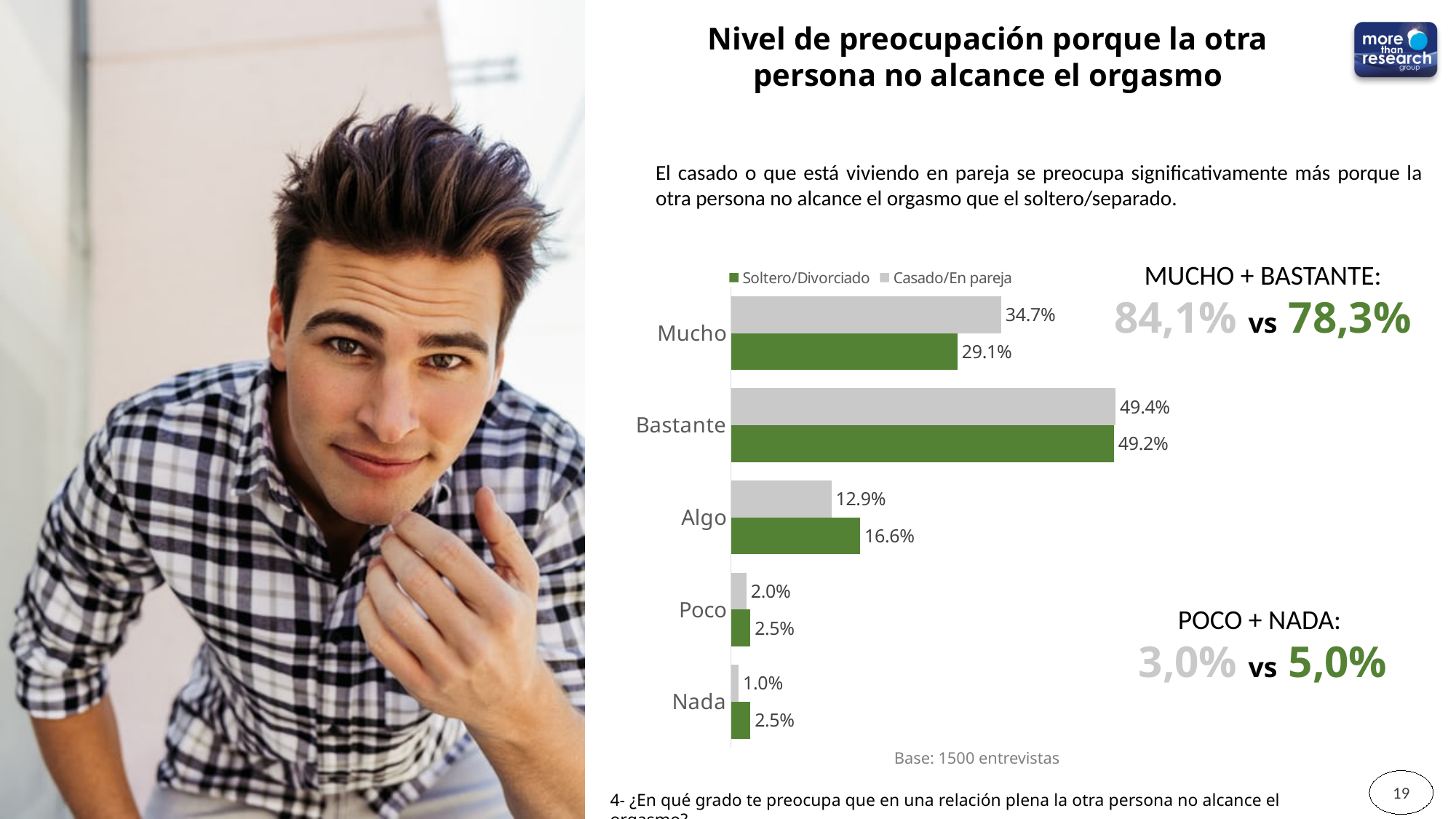
In the Algo category, which series has the larger value, Soltero/Divorciado or Casado/En pareja? Soltero/Divorciado What is the value for Soltero/Divorciado in the Algo category? 16.6% Which category has the lowest value for Casado/En pareja? Nada How many categories are shown on the chart? 5 Which colour represents the Soltero/Divorciado series? Green What is the value for Casado/En pareja in the Mucho category? 34.7% How many series does the legend list? 2 What is the difference between the Casado/En pareja and Soltero/Divorciado values in the Mucho category? 5.6% What kind of chart is shown on the slide? Bar chart What is the title of the chart on the slide? Nivel de preocupación porque la otra persona no alcance el orgasmo Which category has the highest value for Soltero/Divorciado? Bastante What is the value for Casado/En pareja in the Nada category? 1.0%